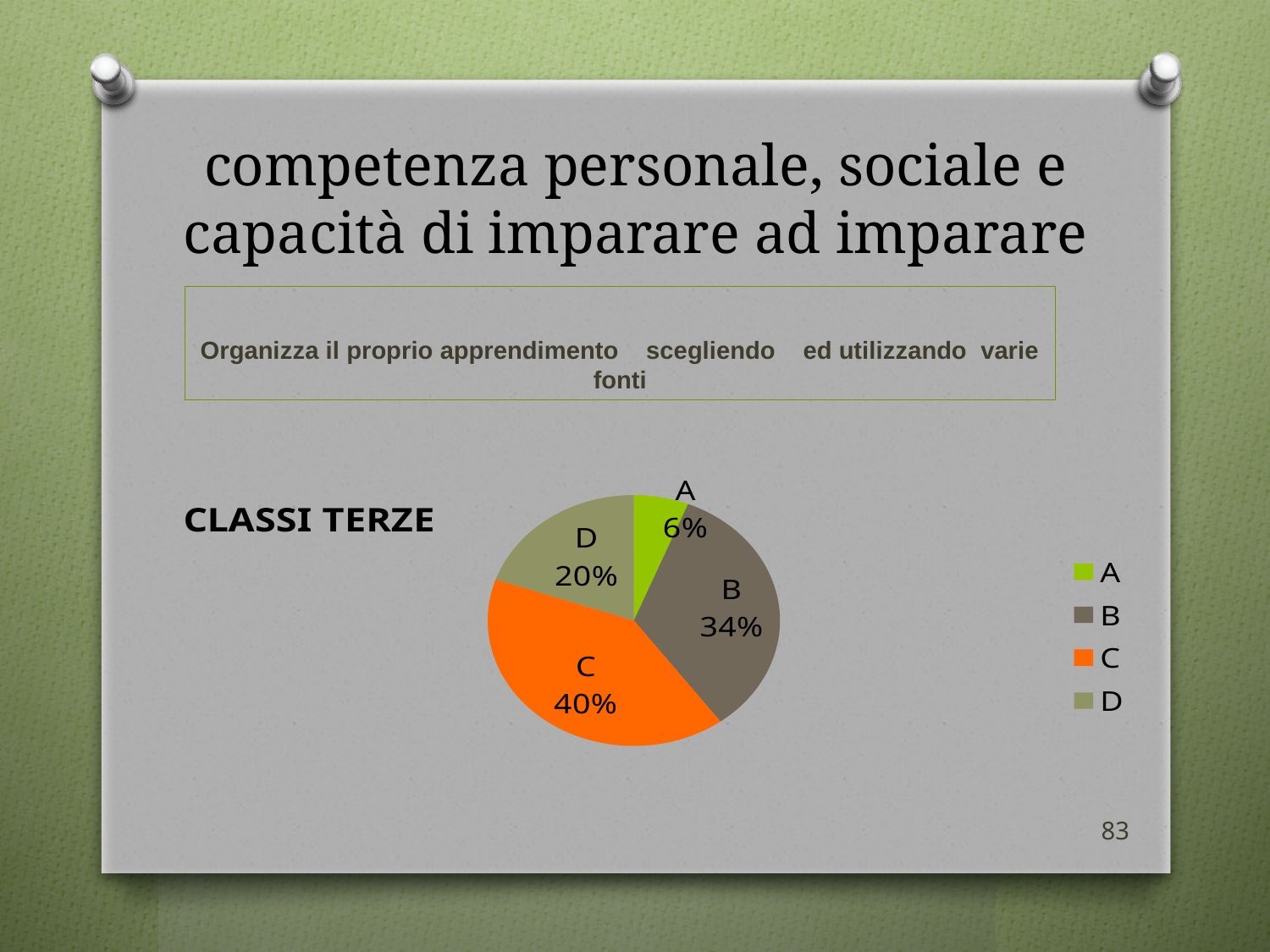
How many entries does the legend list? 4 Which is larger, slice B or slice D? B What is the difference in percentage points between slice C and slice B? 6 Which slice is the largest in the pie chart? C What percentage does slice A represent in the pie chart? 6% What colour is slice C in the pie chart? orange Which slice is the smallest in the pie chart? A What percentage does slice D represent in the pie chart? 20% What type of chart is shown on the slide? pie chart What percentage does slice B represent in the pie chart? 34% How many slices does the pie chart have? 4 What percentage does slice C represent in the pie chart? 40%